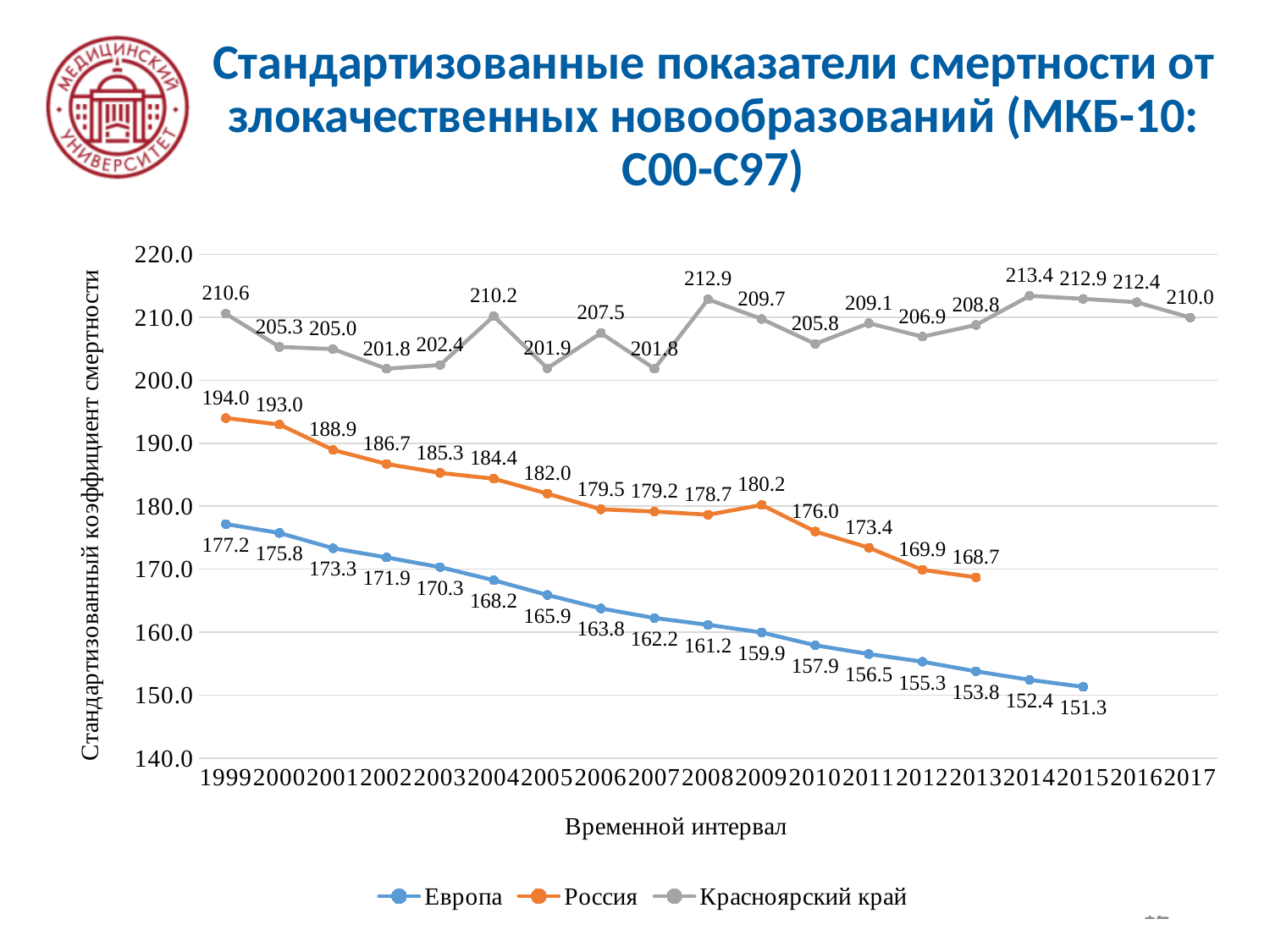
In 2008, which series has the larger value: Россия or Красноярский край? Красноярский край What kind of chart is shown on the slide? line chart What is the value for Европа in 2010? 157.9 What is the value for Россия in 2005? 182.0 How many series does the legend list? 3 In which year does the Европа series have its lowest value? 2015 What is the value for Красноярский край in 2014? 213.4 How many years are shown on the x axis? 19 What is the difference between the Красноярский край values in 2008 and 2007? 11.1 Is the value for Россия in 2001 greater or less than 180? greater In which year does the Красноярский край series reach its highest value? 2014 What is the difference between the Россия values in 1999 and 2013? 25.3